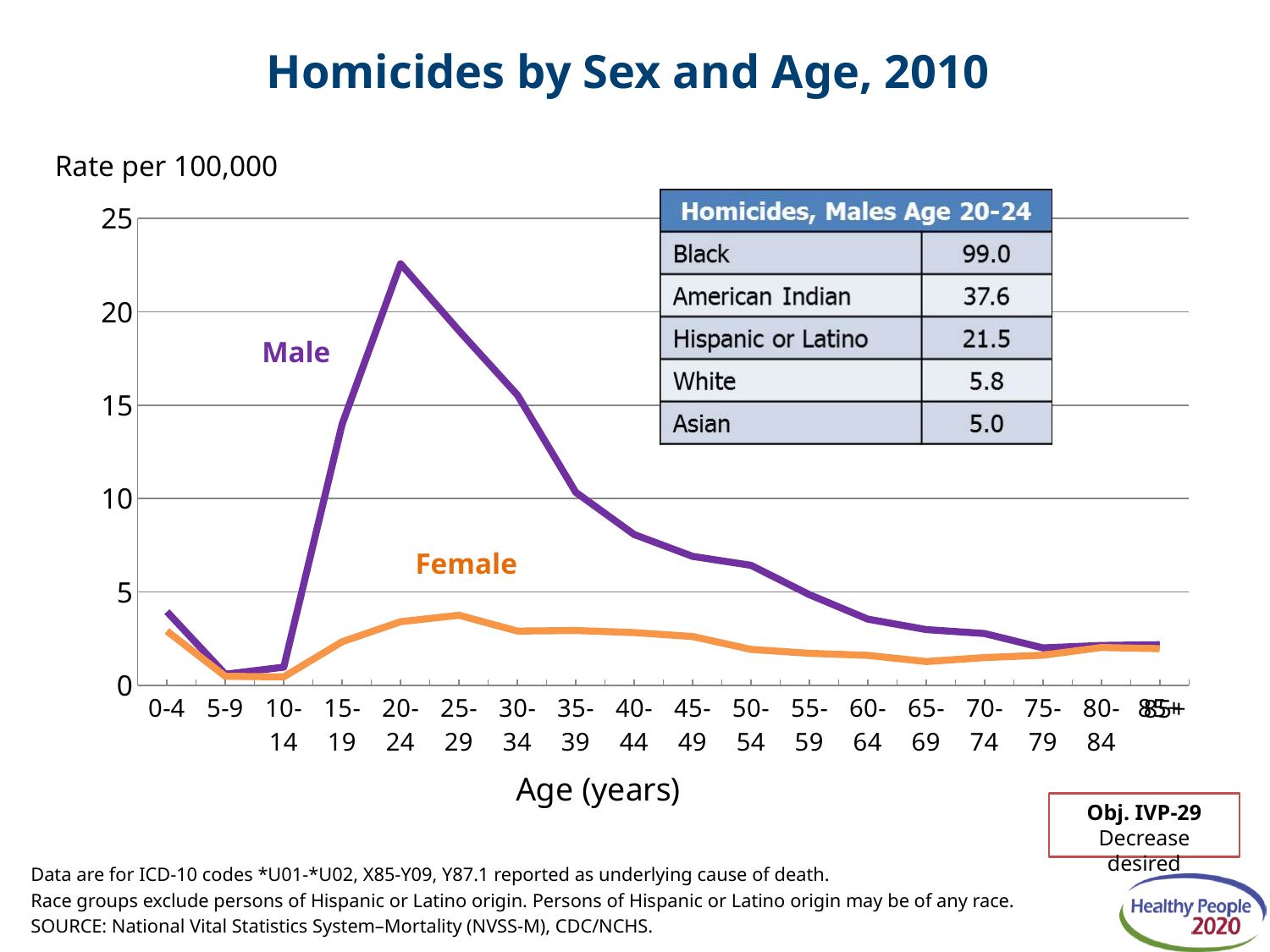
Is the Male rate for ages 40-44 greater or less than 10? less In the inset table of homicides for males age 20-24, what is the rate for Black males? 99.0 At which age group does the Female homicide rate reach its highest value? 25-29 How many age groups are shown along the x axis? 18 How many series are plotted on the chart? 2 What is the title of the chart? Homicides by Sex and Age, 2010 Is the Female rate for ages 20-24 greater or less than 5? less Is the Male rate for ages 20-24 greater or less than 20? greater At which age group does the Male homicide rate reach its highest value? 20-24 What type of chart is shown on the slide? Line chart Does the Male rate rise or fall from ages 20-24 to ages 75-79? Fall Which series has the larger value at ages 20-24, Male or Female? Male